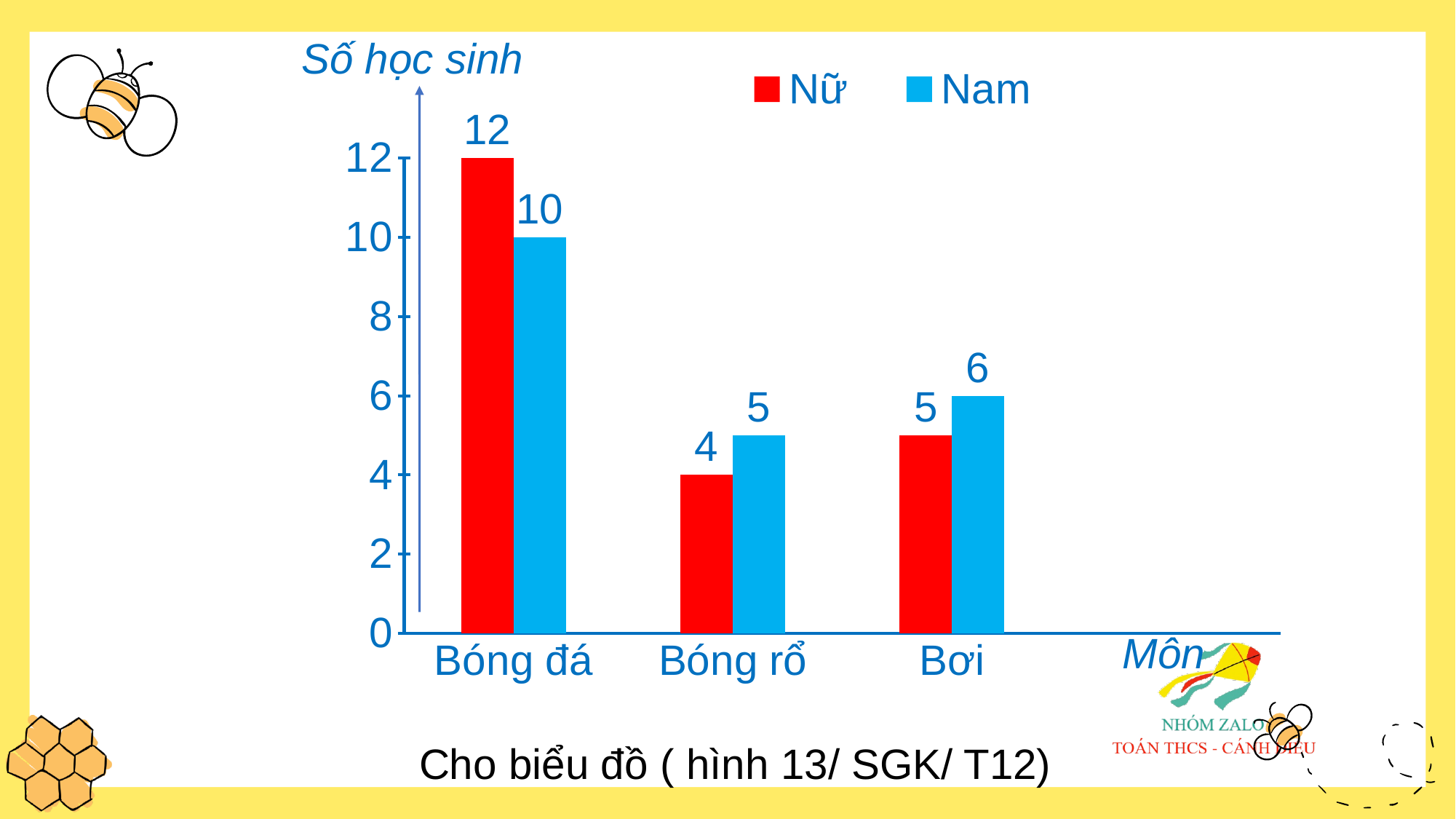
What is the difference between the Nữ and Nam values for Bóng đá? 2 Which category has the highest value for Nam? Bóng đá What is the value for Nữ in the Bơi category? 5 What is the value for Nam in the Bóng rổ category? 5 How many series does the legend list? 2 What kind of chart is shown on the slide? bar chart Is the value for Nam in Bóng đá greater or less than 8? greater What is the label of the vertical axis? Số học sinh Which category has the lowest value for Nữ? Bóng rổ Which is larger in the Bơi category, Nữ or Nam? Nam How many categories are shown on the x axis? 3 What is the value for Nữ in the Bóng đá category? 12